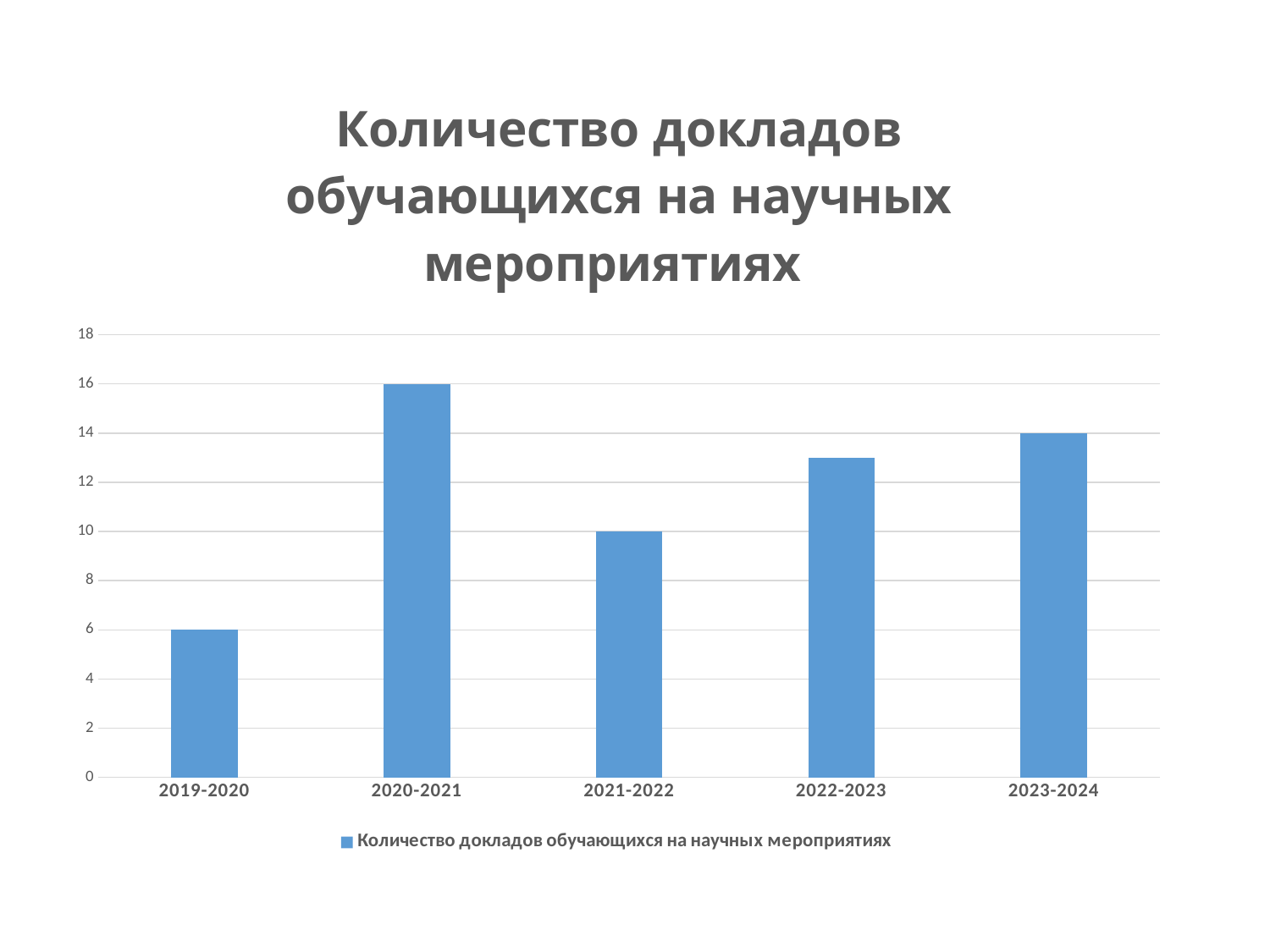
Does the value rise or fall from 2021-2022 to 2022-2023? rise What is the value for 2021-2022? 10 Which is larger, the value for 2020-2021 or the value for 2023-2024? 2020-2021 How many academic years are shown on the x axis? 5 Which academic year has the lowest value? 2019-2020 What kind of chart is shown on the slide? bar chart What is the difference between the values for 2020-2021 and 2019-2020? 10 What is the value for 2023-2024? 14 Is the value for 2022-2023 greater or less than 12? greater What is the value for 2020-2021? 16 Which academic year has the highest value? 2020-2021 What is the value for 2019-2020? 6